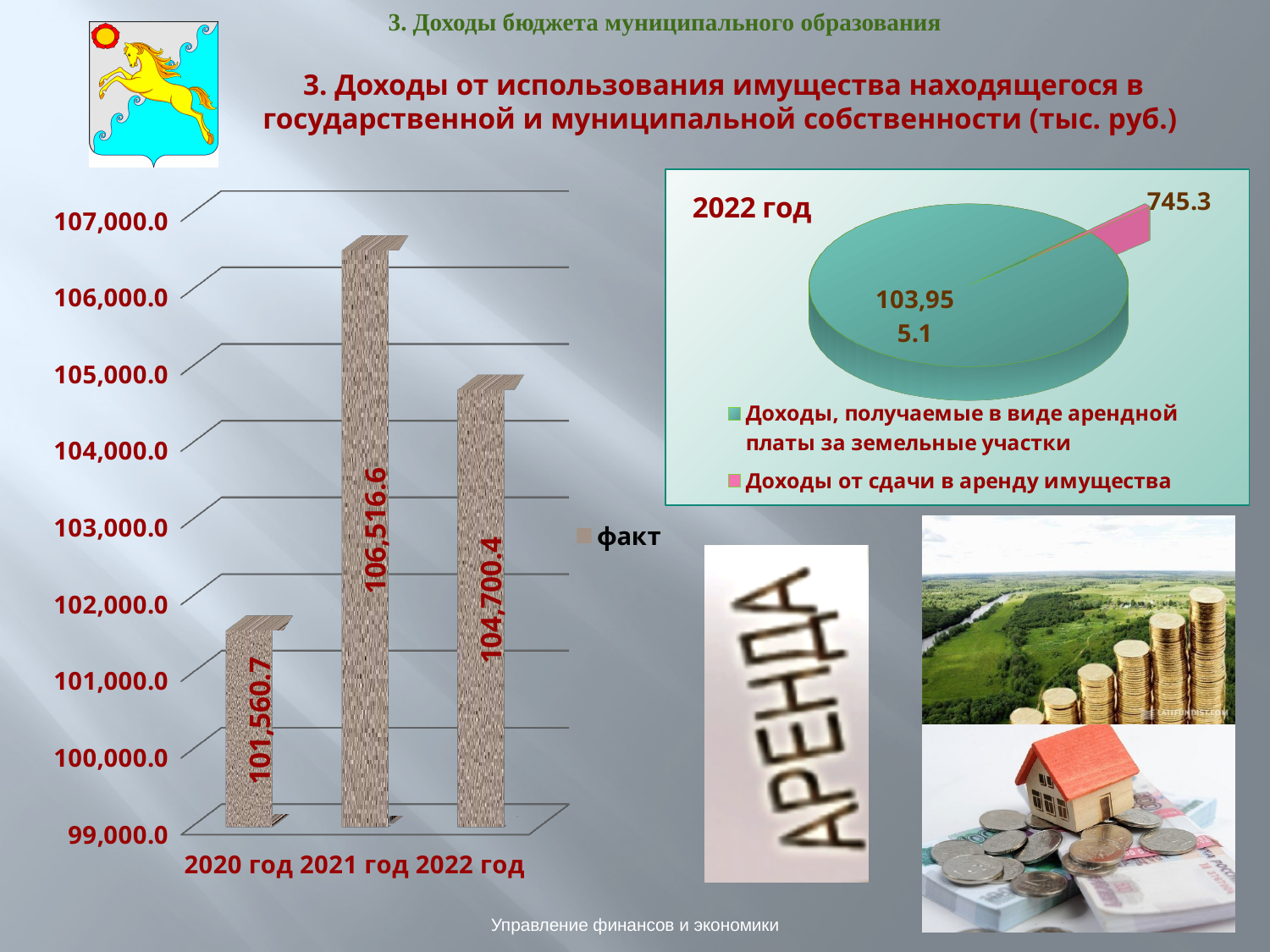
On the bar chart on the left, what is the value for 2021 год? 106,516.6 On the bar chart on the left, what is the difference between the values for 2021 год and 2022 год? 1,816.2 On the bar chart on the left, which is larger: the value for 2022 год or the value for 2020 год? 2022 год On the bar chart on the left, what is the value for 2020 год? 101,560.7 On the pie chart titled 2022 год, how many entries does the legend list? 2 What kind of chart is the chart on the left of the slide? bar chart On the bar chart on the left, what is the value for 2022 год? 104,700.4 On the bar chart on the left, how many years are shown? 3 On the bar chart on the left, what is the difference between the values for 2021 год and 2020 год? 4,955.9 On the bar chart on the left, which year has the lowest value? 2020 год On the bar chart on the left, which year has the highest value? 2021 год On the pie chart titled 2022 год, what is the value for Доходы от сдачи в аренду имущества? 745.3